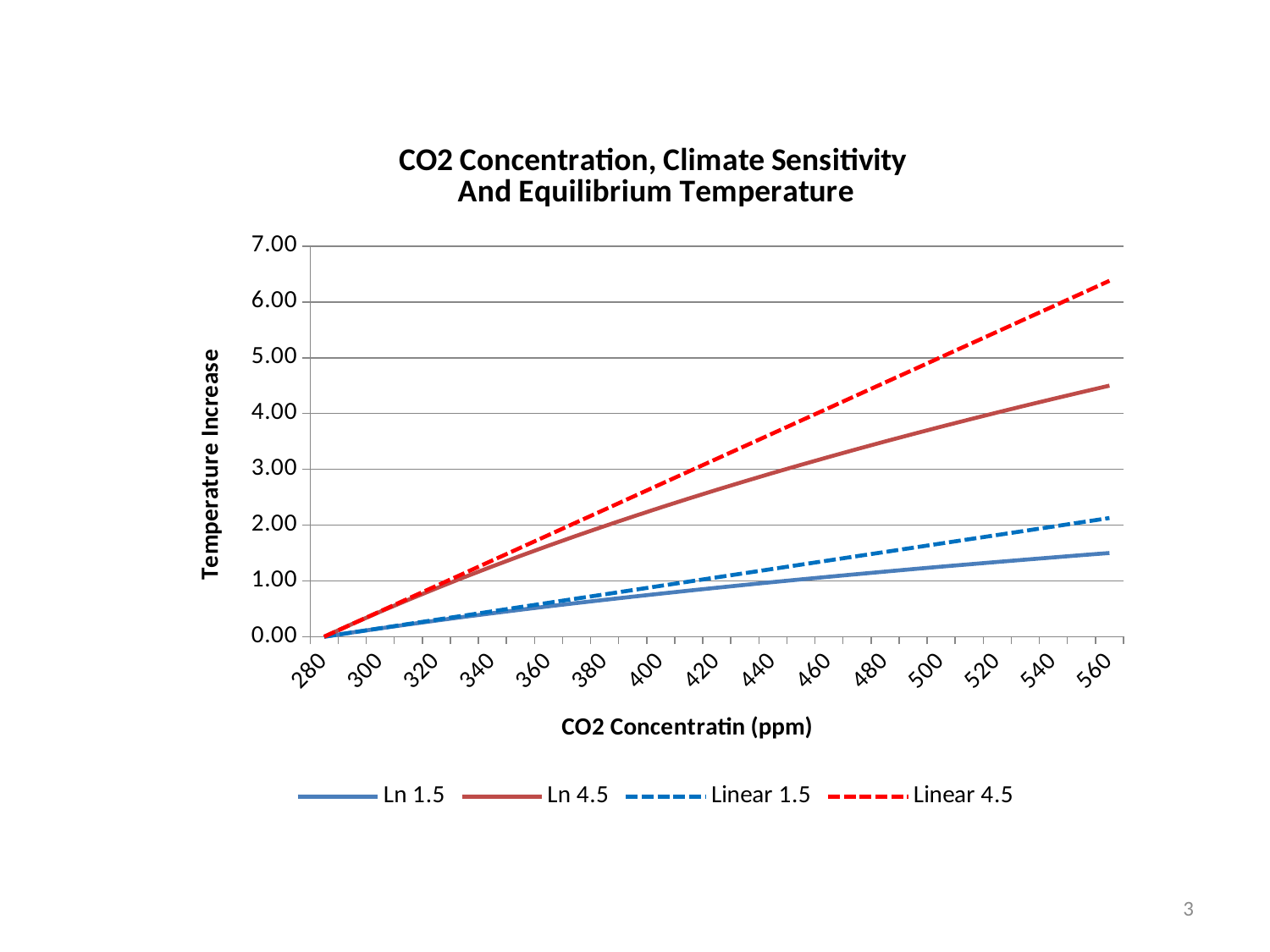
Is the value for Linear 4.5 at 560 ppm greater or less than 6.00? greater Which series has the lowest temperature increase at 560 ppm? Ln 1.5 Which series has the highest temperature increase at 560 ppm? Linear 4.5 Is the value for Ln 4.5 at 560 ppm greater or less than 4.00? greater Which two series are drawn with dashed lines? Linear 1.5 and Linear 4.5 What kind of chart is shown on the slide? line chart What is the label on the y axis? Temperature Increase At 560 ppm, which is larger: Ln 4.5 or Linear 4.5? Linear 4.5 Is the value for Ln 1.5 at 560 ppm greater or less than 2.00? less How many series does the legend list? 4 Do the values for Ln 4.5 rise or fall as CO2 concentration increases along the x axis? rise